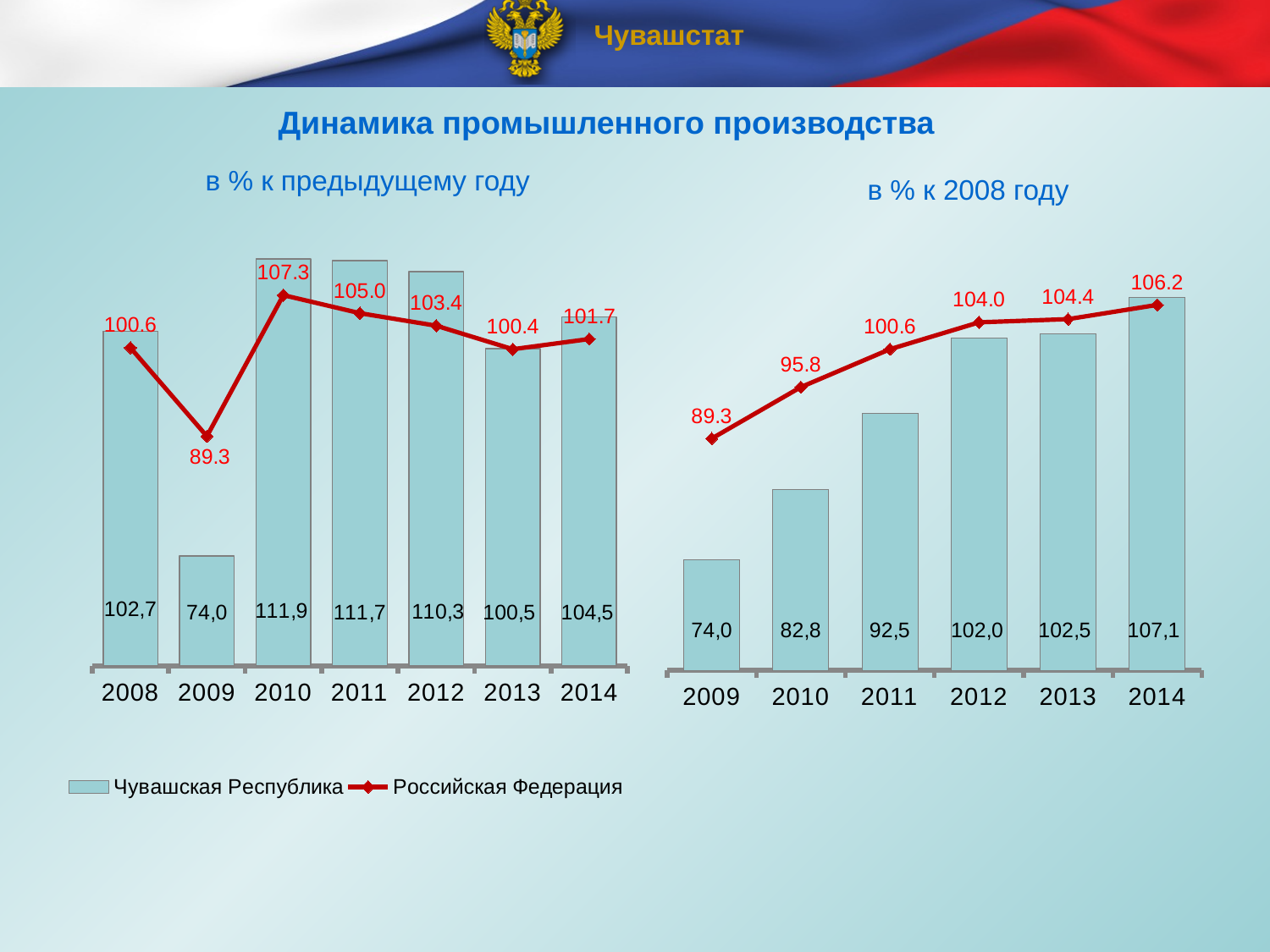
On the left chart (в % к предыдущему году), which year has the highest value for Российская Федерация? 2010 On the left chart (в % к предыдущему году), what is the difference between the Чувашская Республика values for 2010 and 2009? 37,9 On the left chart (в % к предыдущему году), what is the value for Российская Федерация in 2009? 89.3 On the right chart (в % к 2008 году), what is the value for Российская Федерация in 2011? 100.6 On the left chart (в % к предыдущему году), what is the value for Чувашская Республика in 2010? 111,9 On the right chart (в % к 2008 году), do the Чувашская Республика values rise or fall from 2009 to 2014? rise On the right chart (в % к 2008 году), which year has the highest value for Чувашская Республика? 2014 How many series does the legend list? 2 How many years are shown on the x axis of the right chart (в % к 2008 году)? 6 On the right chart (в % к 2008 году), what is the value for Чувашская Республика in 2014? 107,1 On the left chart (в % к предыдущему году), which year has the lowest value for Чувашская Республика? 2009 On the right chart (в % к 2008 году), which is larger in 2012: the value for Чувашская Республика or for Российская Федерация? Российская Федерация